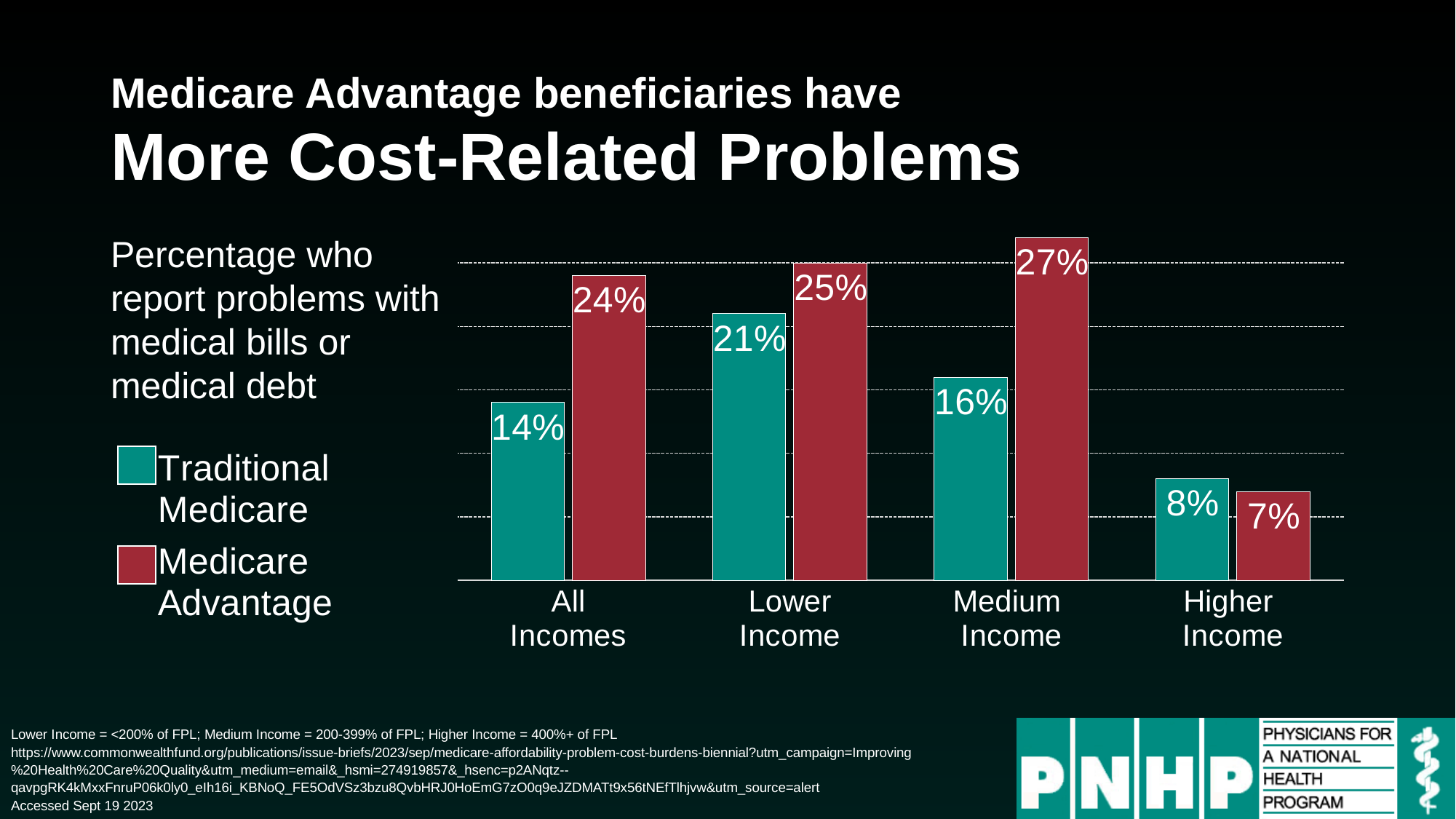
What is the value for Medicare Advantage in the Higher Income category? 7% What percentage of Medicare Advantage beneficiaries with Medium Income report problems with medical bills or medical debt? 27% Which income category has the highest value for Medicare Advantage? Medium Income What is the difference between the Medicare Advantage and Traditional Medicare values for Medium Income? 11% How many series does the legend list? 2 In the Higher Income category, which is larger: Traditional Medicare or Medicare Advantage? Traditional Medicare What is the value for Traditional Medicare in the Lower Income category? 21% What kind of chart is shown on the slide? Bar chart Which income category has the lowest value for Traditional Medicare? Higher Income What percentage of Traditional Medicare beneficiaries with All Incomes report problems with medical bills or medical debt? 14% What is the difference between the Medicare Advantage and Traditional Medicare values for All Incomes? 10% How many income categories are shown on the x axis? 4